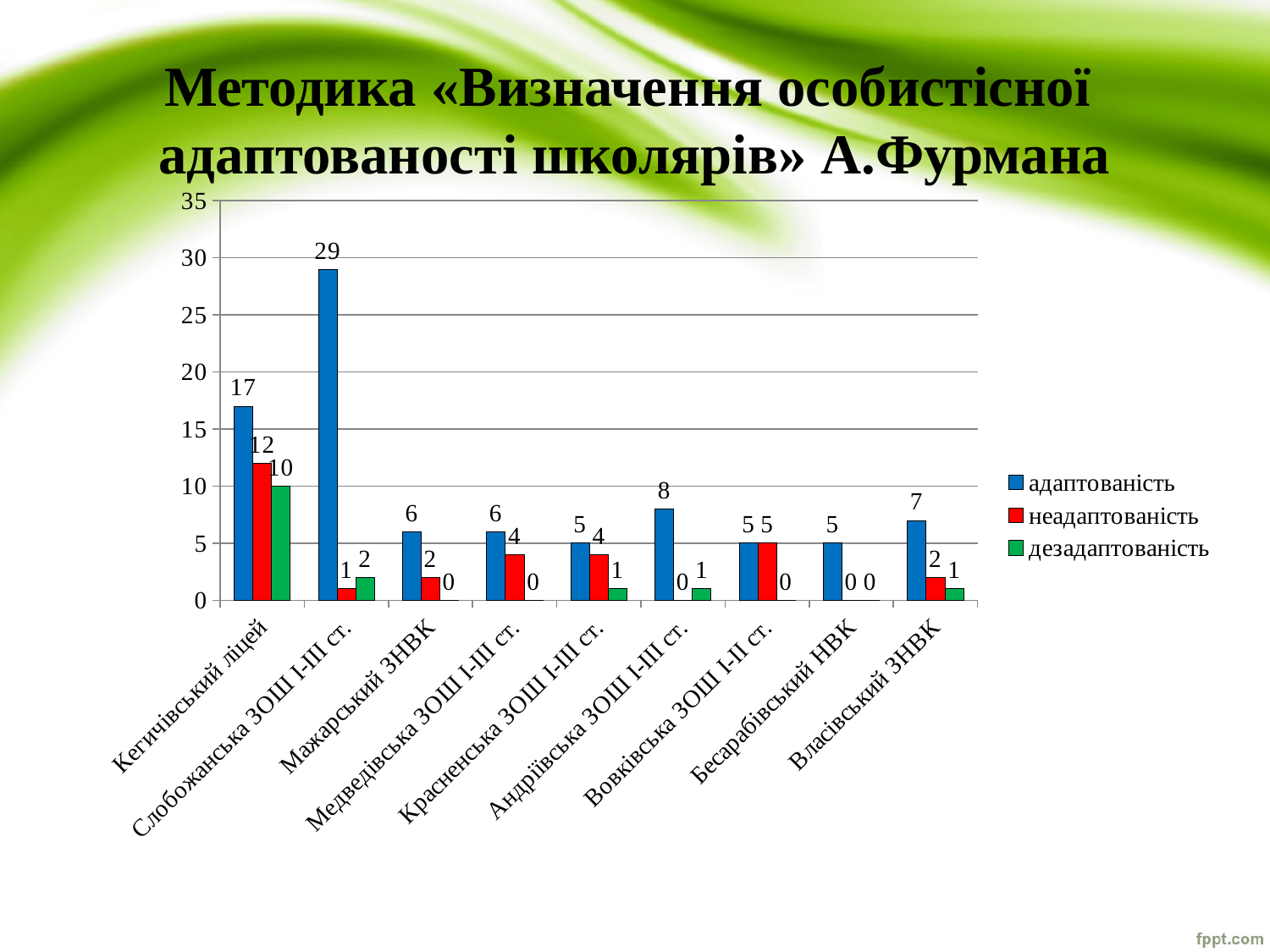
What is the total of the three values for Кегичівський ліцей? 39 Which school has the highest дезадаптованість value? Кегичівський ліцей What is the difference between the адаптованість values of Слобожанська ЗОШ І-ІІІ ст. and Кегичівський ліцей? 12 What is the адаптованість value for Слобожанська ЗОШ І-ІІІ ст.? 29 What is the дезадаптованість value for Власівський ЗНВК? 1 What is the неадаптованість value for Кегичівський ліцей? 12 Which colour represents неадаптованість in the legend? red How many series does the legend list? 3 Which school has the highest адаптованість value? Слобожанська ЗОШ І-ІІІ ст. Which is larger for Медведівська ЗОШ І-ІІІ ст.: адаптованість or неадаптованість? адаптованість How many schools (categories) are shown on the x axis? 9 What type of chart is shown on the slide? bar chart